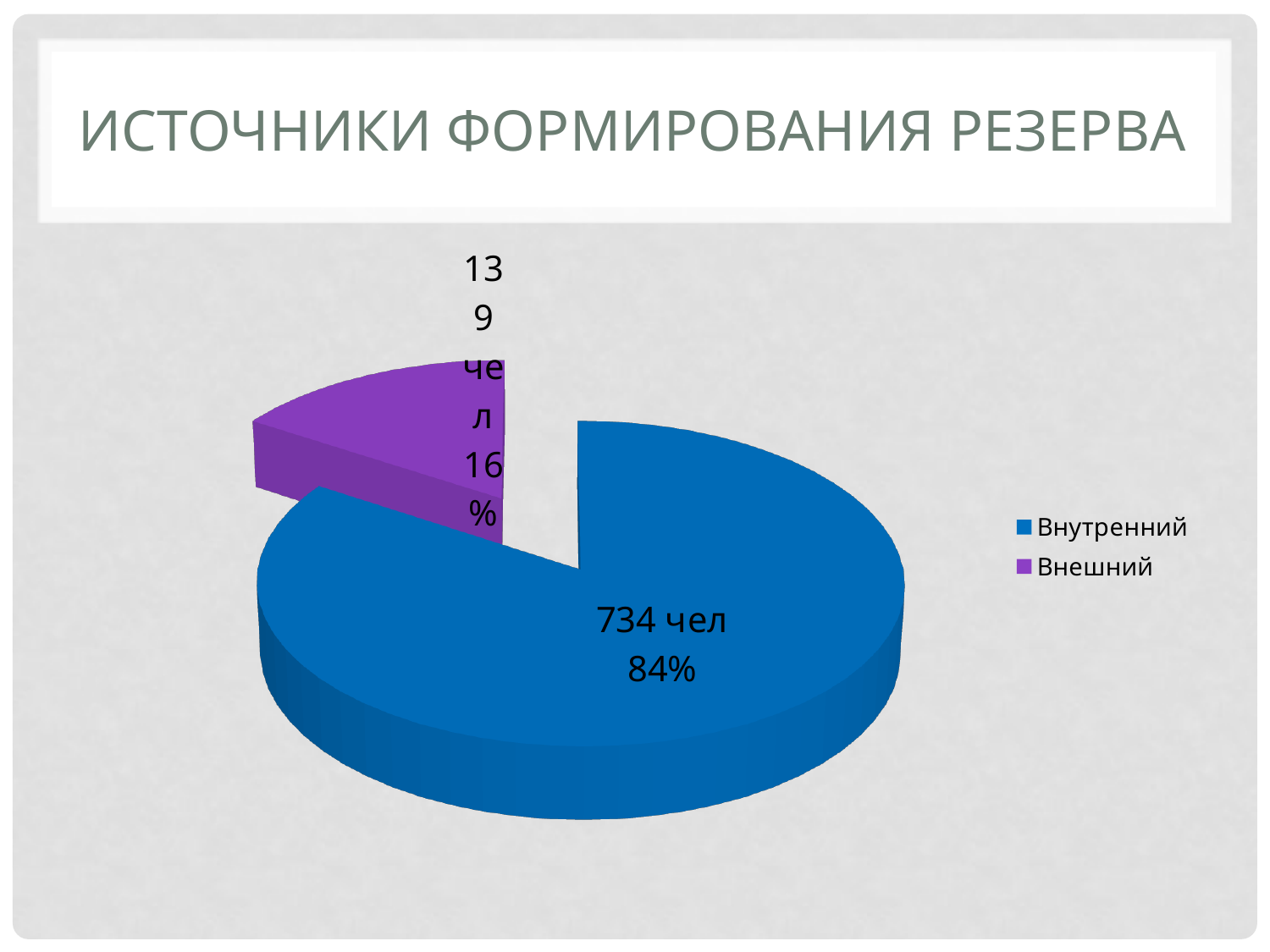
What kind of chart is shown on the slide? pie chart Which colour is used for the Внешний slice? purple What is the value shown for Внутренний? 734 чел What is the title of the chart on the slide? ИСТОЧНИКИ ФОРМИРОВАНИЯ РЕЗЕРВА Which slice is the largest? Внутренний How many entries does the legend list? 2 What is the value shown for Внешний? 139 чел Which slice is the smallest? Внешний What is the difference between the values for Внутренний and Внешний? 595 чел How many slices does the pie chart have? 2 What share of the pie does Внутренний represent? 84% What share of the pie does Внешний represent? 16%